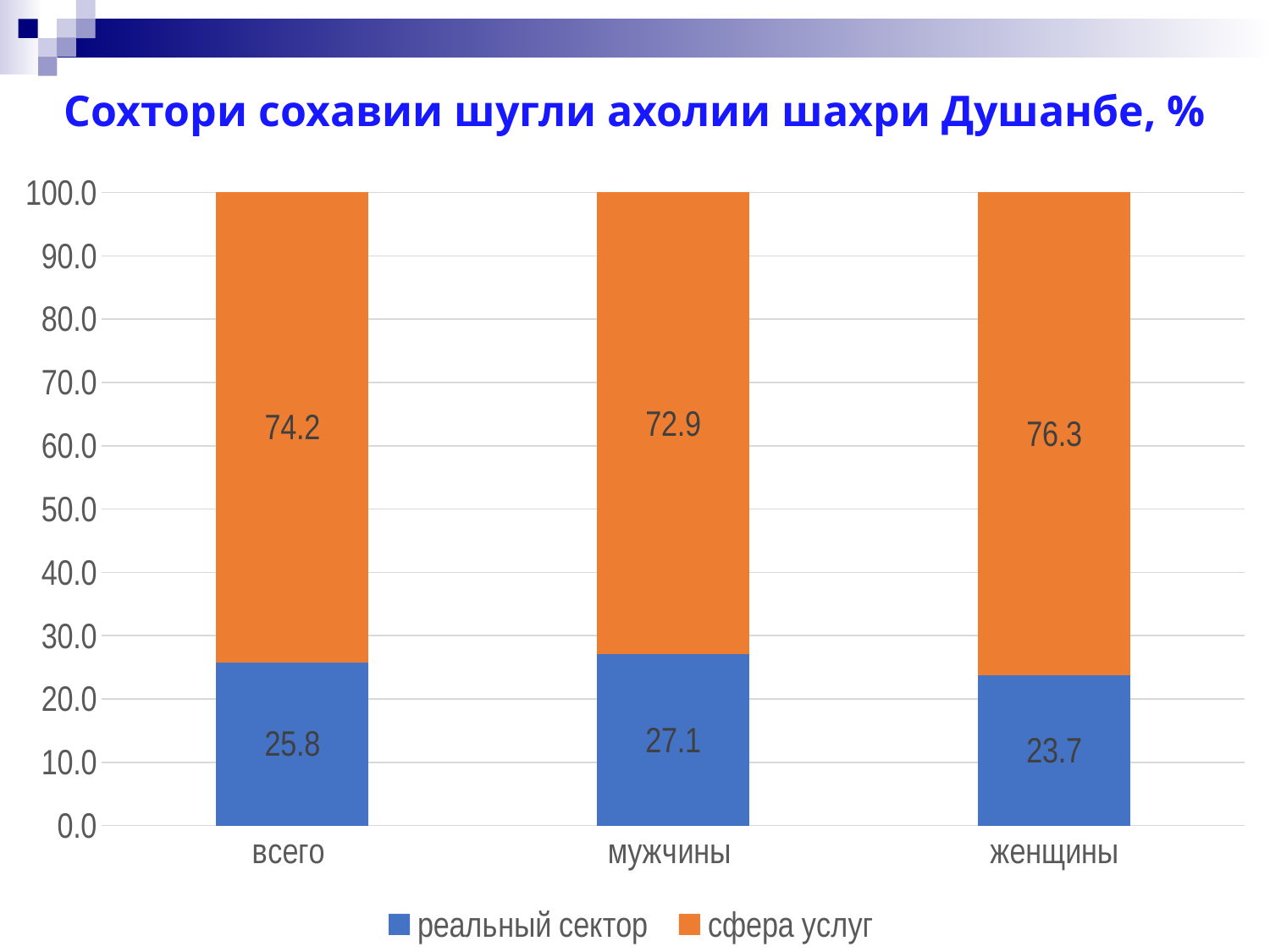
What is the value of реальный сектор for всего? 25.8 What is the difference between the сфера услуг values for женщины and всего? 2.1 What is the value of реальный сектор for мужчины? 27.1 What is the value of сфера услуг for мужчины? 72.9 What is the total of the stacked bar for мужчины? 100.0 What kind of chart is shown on the slide? Stacked bar chart How many categories are shown on the x axis? 3 Which is larger: реальный сектор for всего or реальный сектор for женщины? всего Which category has the lowest value for сфера услуг? мужчины How many series does the legend list? 2 Which category has the highest value for реальный сектор? мужчины What is the value of сфера услуг for женщины? 76.3